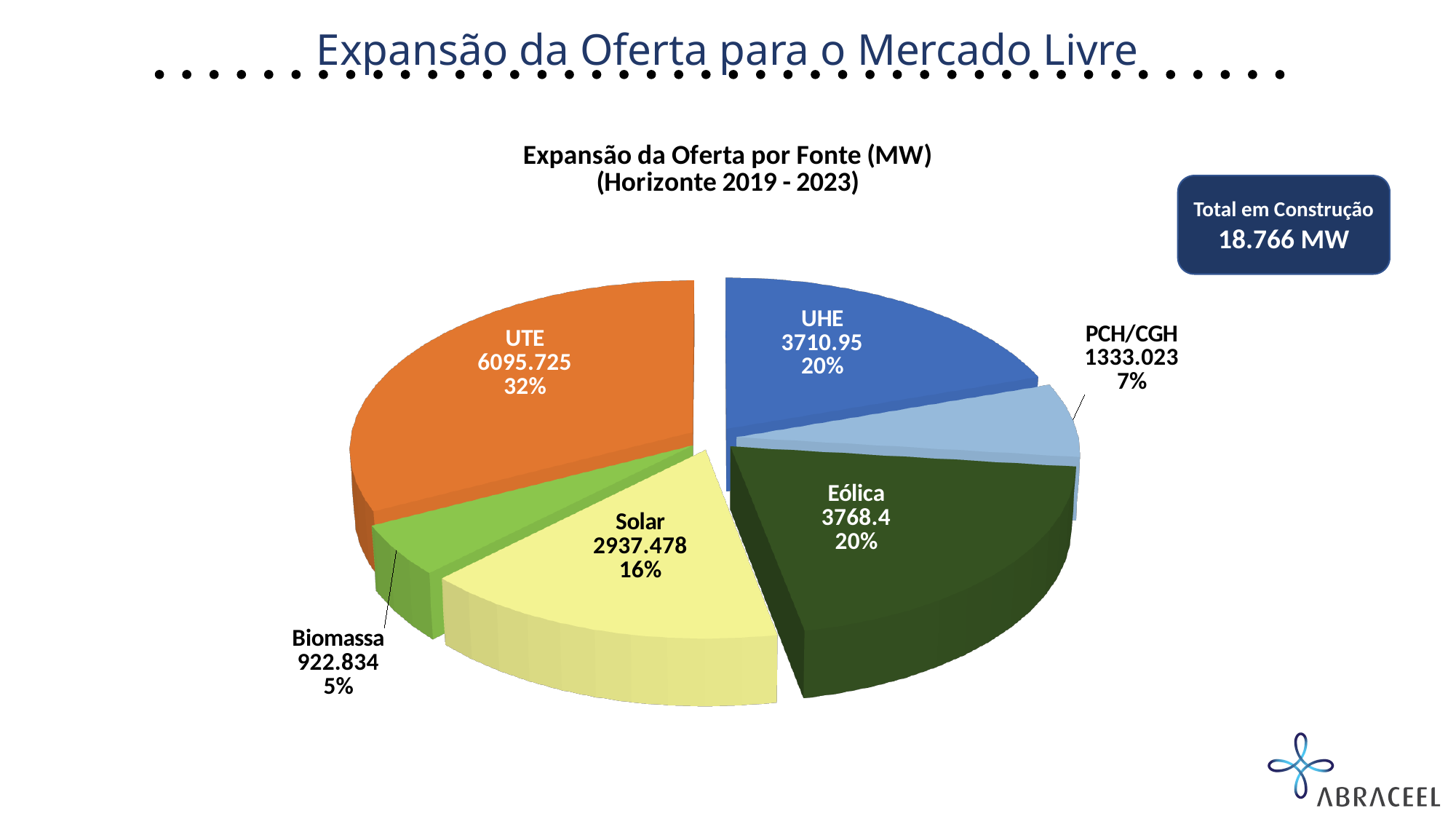
What share of the pie does Solar represent? 16% Which source has the largest slice of the pie chart? UTE What is the title of the pie chart? Expansão da Oferta por Fonte (MW) (Horizonte 2019 - 2023) What is the value for PCH/CGH in the pie chart? 1333.023 What is the value for UTE in the pie chart? 6095.725 What is the difference between the values for UTE and Solar? 3158.247 How many sources (slices) are shown in the pie chart? 6 What is the value for Eólica in the pie chart? 3768.4 Which source has the smallest slice of the pie chart? Biomassa What share of the pie does UHE represent? 20% What kind of chart is shown on the slide? Pie chart Which is larger, the value for Solar or the value for PCH/CGH? Solar